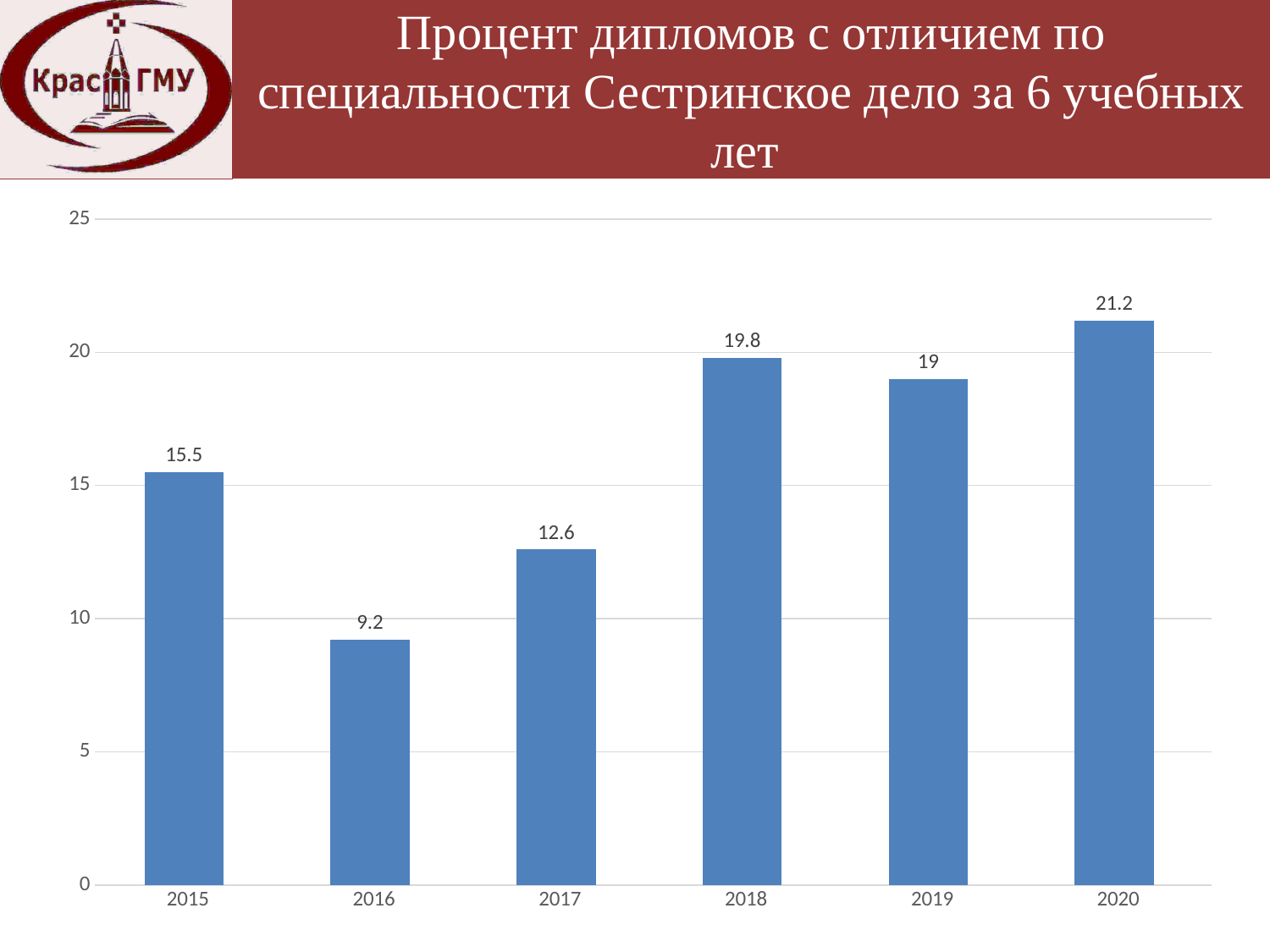
What is the value for 2018? 19.8 What is the difference between the values for 2020 and 2016? 12 What kind of chart is shown on the slide? bar chart Which is larger, the value for 2017 or the value for 2019? 2019 Do the values rise or fall from 2016 to 2018? rise What is the difference between the values for 2018 and 2019? 0.8 Which year has the highest value? 2020 Is the value for 2016 greater or less than 10? less What is the value for 2015? 15.5 How many years are shown on the x axis? 6 Which year has the lowest value? 2016 What is the value for 2020? 21.2